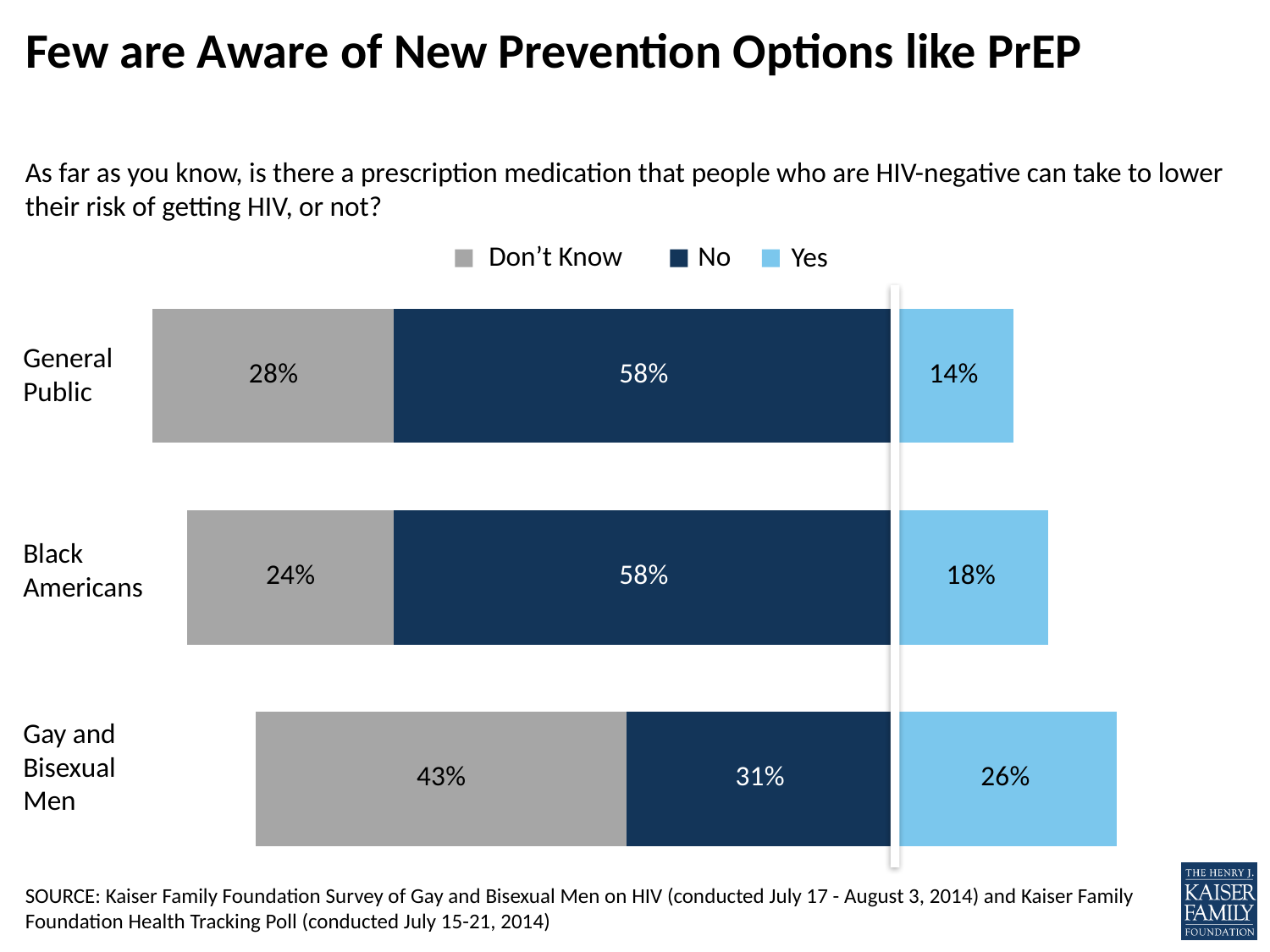
What percentage of the General Public answered "Yes"? 14% How many series does the legend list? 3 What kind of chart is shown on the slide? Stacked bar chart What is the difference between the "Yes" percentage for Gay and Bisexual Men and the General Public? 12 percentage points What is the total of the three segments in the Gay and Bisexual Men bar? 100% Which group has the lowest "Don't Know" percentage? Black Americans Which group has the highest "Yes" percentage? Gay and Bisexual Men What percentage of Black Americans answered "No"? 58% How many groups are shown in the chart? 3 Which is larger: the "No" percentage for the General Public or for Gay and Bisexual Men? General Public Which colour represents the "Yes" response in the legend? Light blue What percentage of Gay and Bisexual Men answered "Don't Know"? 43%